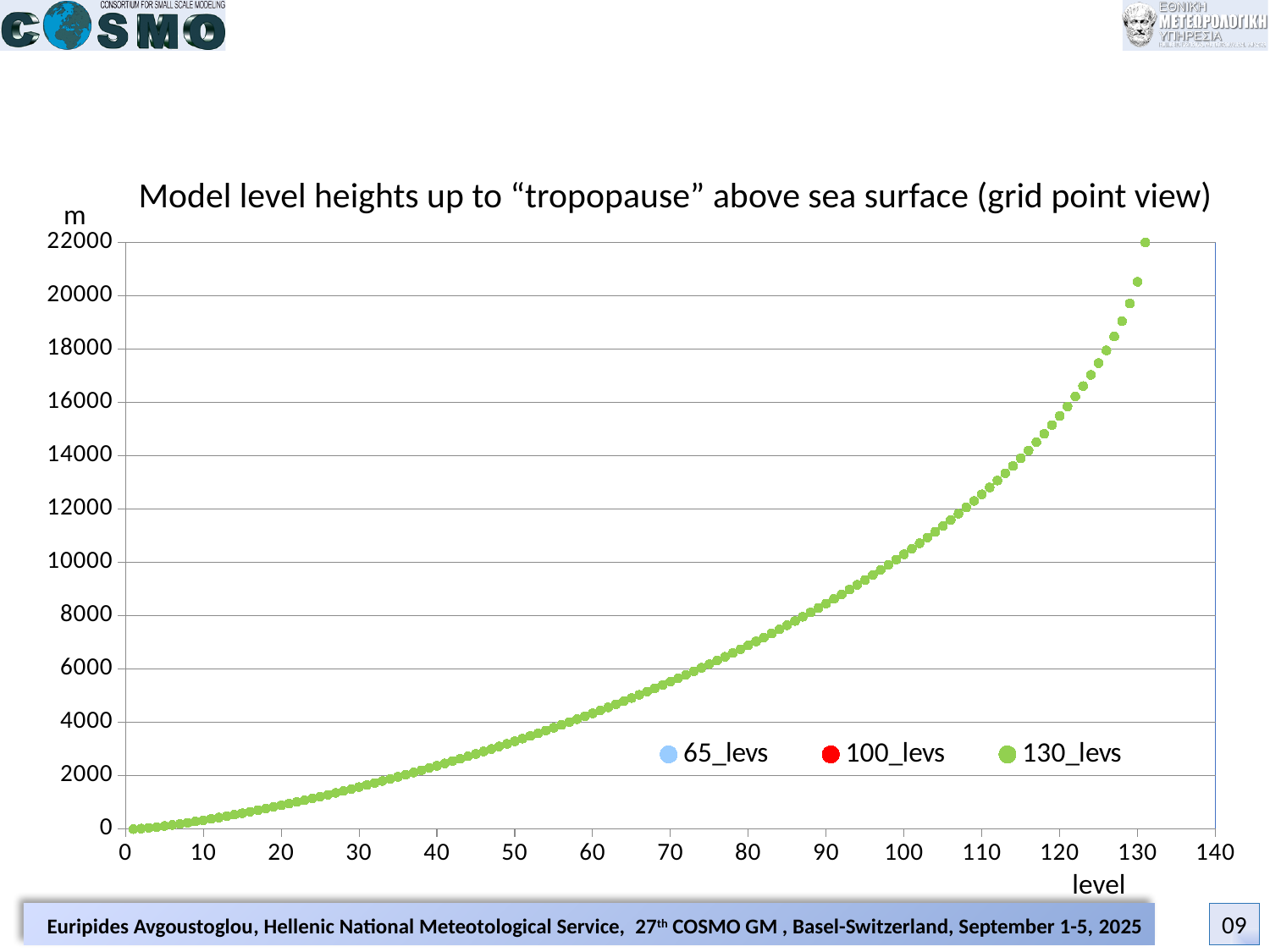
How many series does the legend list? 3 Which is larger, the height at level 100 or the height at level 60? level 100 Is the height for level 80 greater or less than 6000? greater Is the height for level 40 greater or less than 2000? greater Do the model level heights rise or fall as the level number increases along the x axis? rise What colour are the markers for the 130_levs series in the legend? green What kind of chart is shown on the slide? scatter chart Is the height for level 60 greater or less than 4000? greater What is the title of the chart? Model level heights up to "tropopause" above sea surface (grid point view)